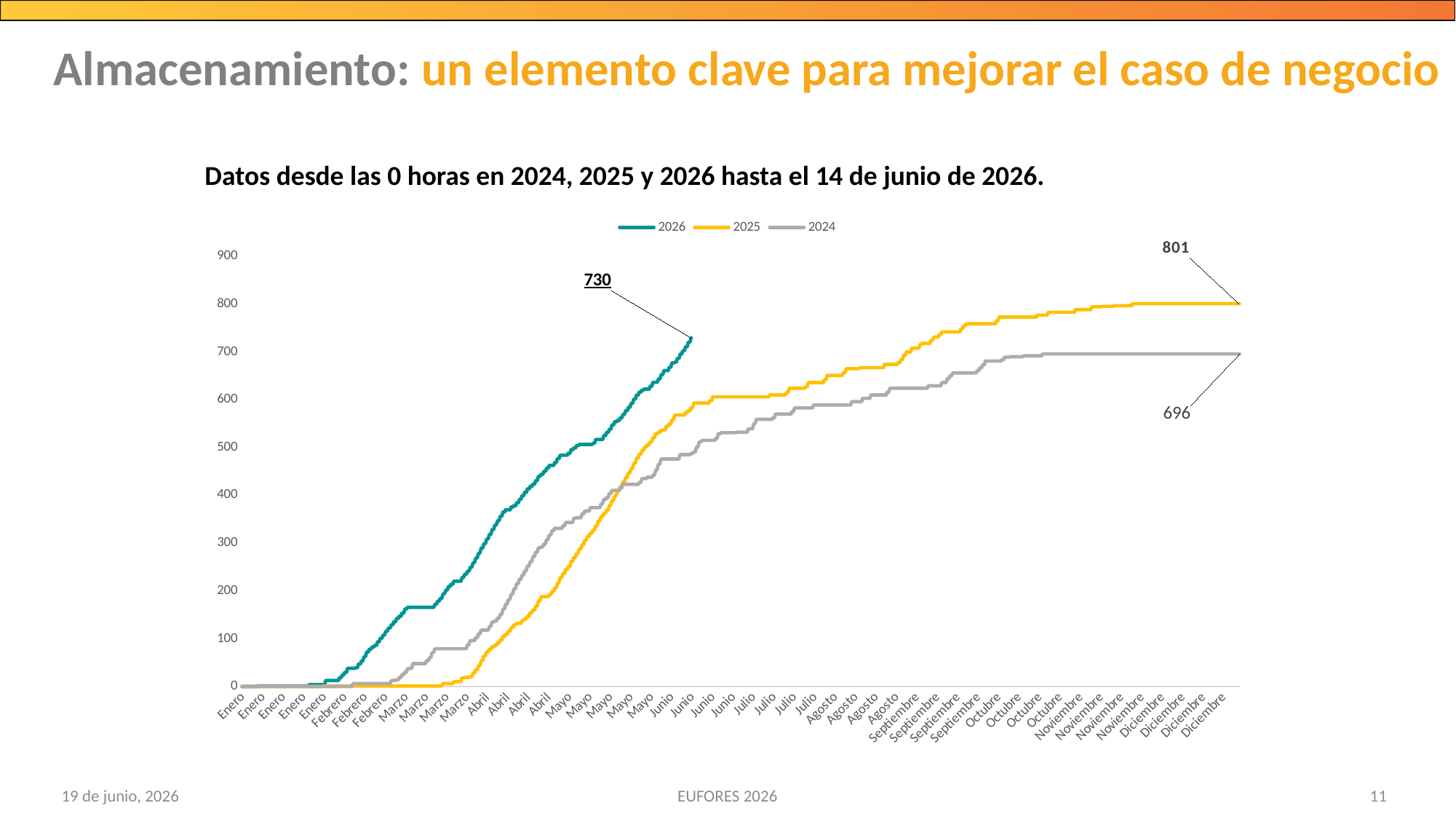
What is the final labelled value of the 2024 series? 696 Is the 2025 value at the end of March greater or less than 100? less Do the values of each series rise or fall along the x axis? rise What is the difference between the labelled end values of 2025 and 2024? 105 How many series does the chart legend list? 3 What is the labelled value reached by the 2026 series in June? 730 What is the difference between the 2025 end value (801) and the 2026 June value (730)? 71 Which series has the lowest labelled end value? 2024 What is the final labelled value of the 2025 series? 801 Which series has the highest labelled end value? 2025 What kind of chart is shown on the slide? line chart Which is larger: the 2026 value in June (730) or the 2024 end value (696)? 2026 (730)